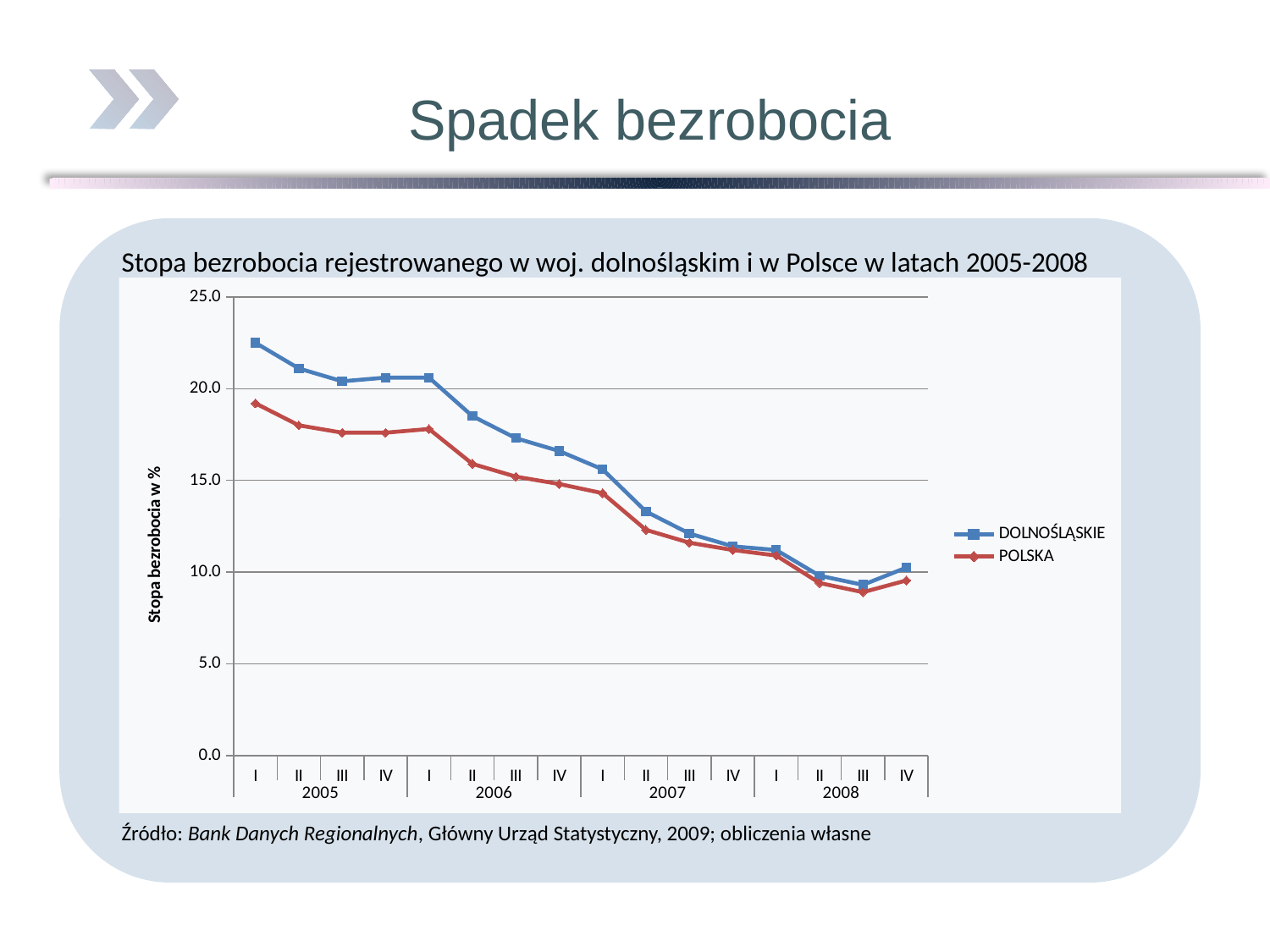
Is the value for DOLNOŚLĄSKIE in quarter I of 2005 greater or less than 20.0? greater How many quarterly data points does each series have? 16 In which quarter is the DOLNOŚLĄSKIE series at its highest? I 2005 Which series has the higher value in quarter I of 2006, DOLNOŚLĄSKIE or POLSKA? DOLNOŚLĄSKIE Which two series are listed in the chart legend? DOLNOŚLĄSKIE and POLSKA Is the value for POLSKA in quarter I of 2007 greater or less than 15.0? less Is the value for POLSKA in quarter I of 2005 greater or less than 20.0? less What kind of chart is shown on the slide? line chart In which quarter is the POLSKA series at its lowest? III 2008 How many series does the legend list? 2 Do the unemployment rates rise or fall overall from 2005 to 2008? fall